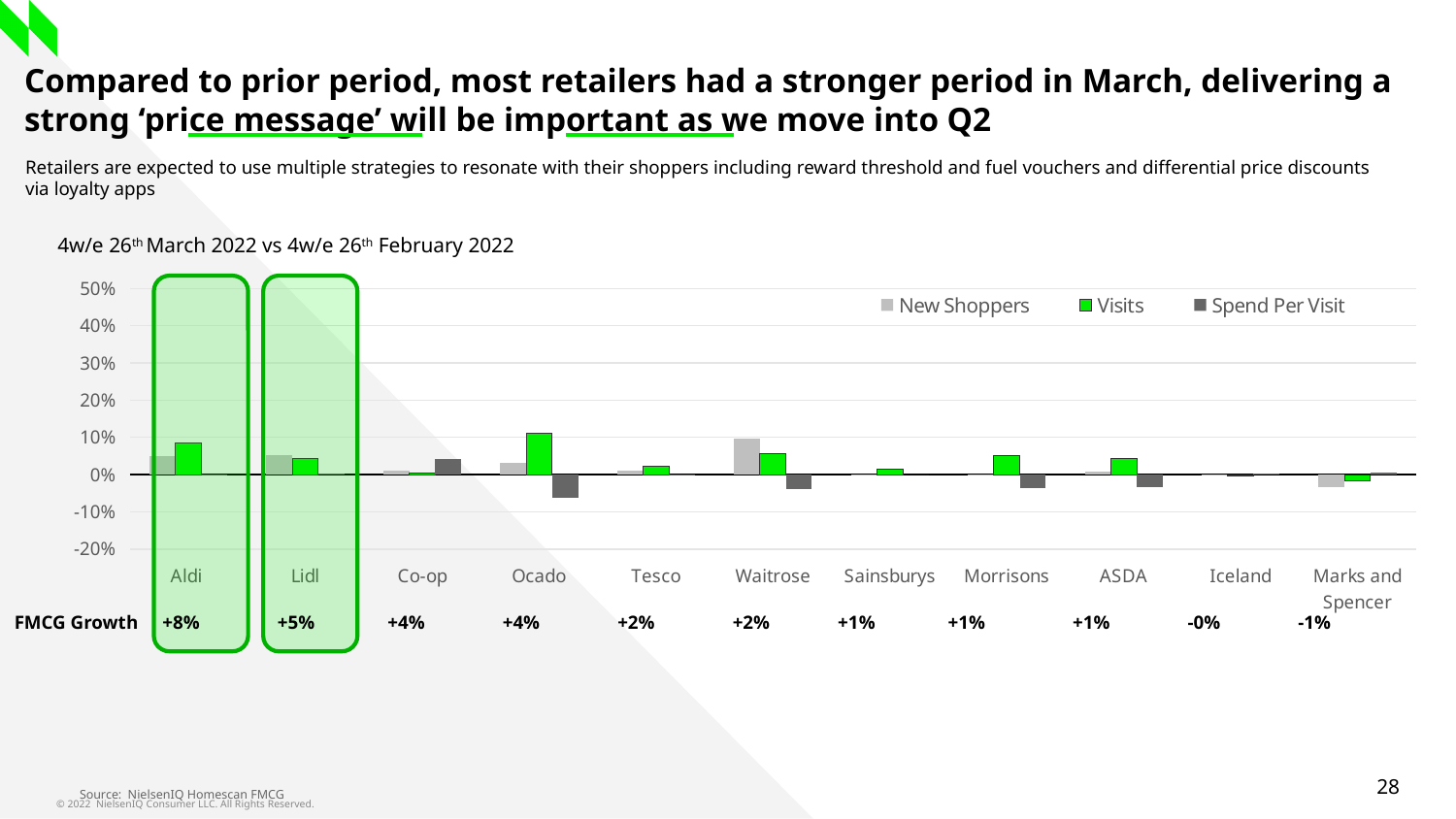
What is the FMCG Growth value shown for Aldi? +8% Which series is shown in bright green in the legend? Visits How many retailers are shown along the x axis of the chart? 11 Is the Visits bar for Aldi greater or less than 10%? less Which retailer has the tallest Visits bar? Ocado Which retailer has the highest FMCG Growth value? Aldi What is the difference in FMCG Growth between Aldi and Lidl? 3 percentage points What kind of chart is shown on the slide? Bar chart Which retailer has the tallest New Shoppers bar? Waitrose What is the FMCG Growth value shown for Iceland? -0% What is the FMCG Growth value shown for Marks and Spencer? -1% How many series does the chart legend list? 3